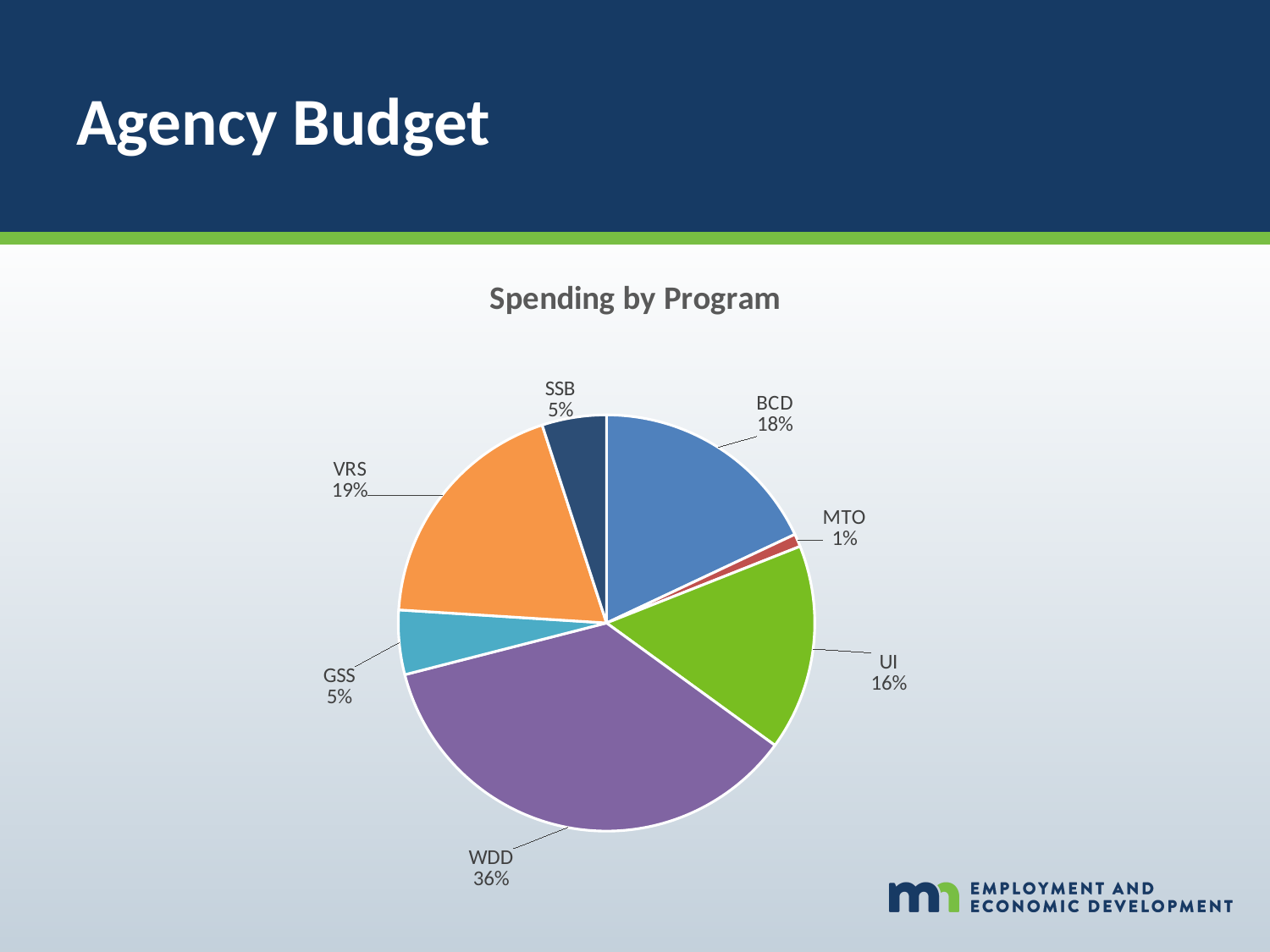
What type of chart is shown on the slide? pie chart What share of spending goes to WDD? 36% Which program has the smallest share of spending? MTO How many programs are shown in the pie chart? 7 What share of spending goes to BCD? 18% What share of spending goes to VRS? 19% Which program has the largest share of spending? WDD What colour is the WDD slice? purple What is the difference in percentage points between WDD and UI? 20 What share of spending goes to MTO? 1% What is the title of the chart? Spending by Program Which has a larger share of spending, BCD or UI? BCD